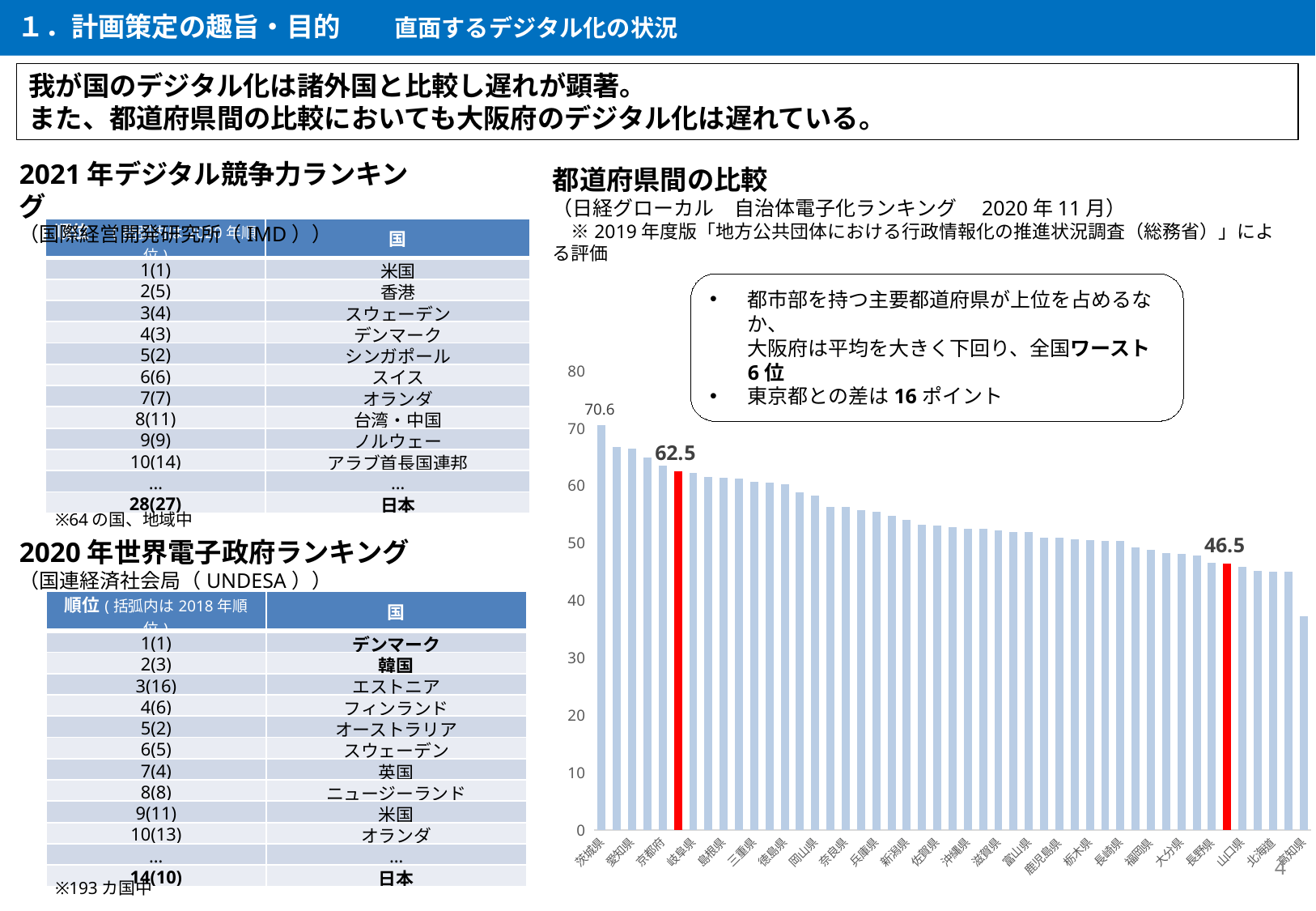
In the prefecture comparison bar chart, what is the value printed on the tallest (leftmost) bar? 70.6 In the prefecture comparison bar chart, what colour are the two highlighted bars? red In the prefecture comparison bar chart, is the value of the last (rightmost) bar greater or less than 40? less In the prefecture comparison bar chart, what value is printed above the second (right) red bar? 46.5 In the prefecture comparison bar chart, do the bar values rise or fall from left to right? fall What kind of chart is shown on the right side of the slide under 都道府県間の比較? bar chart In the prefecture comparison bar chart, which red bar is larger, the left one or the right one? the left one (62.5) In the prefecture comparison bar chart, is the value of the right red bar greater or less than 50? less In the prefecture comparison bar chart, is the value of the left red bar greater or less than 60? greater In the prefecture comparison bar chart, what is the difference between the tallest bar (70.6) and the left red bar (62.5)? 8.1 In the prefecture comparison bar chart, what value is printed above the first (left) red bar? 62.5 In the prefecture comparison bar chart, what is the difference between the two red bars (62.5 and 46.5)? 16